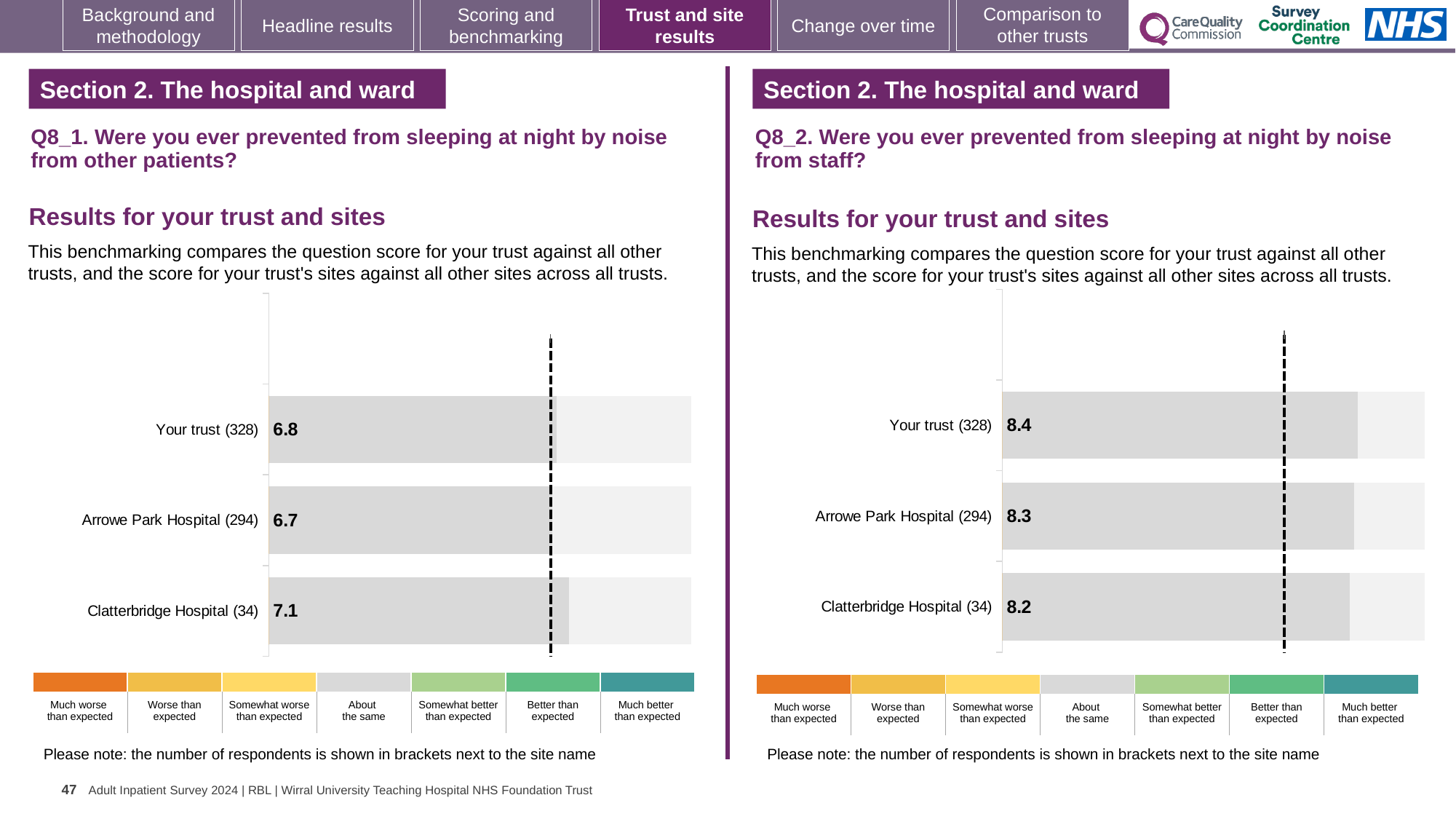
On the Q8_1 chart (noise from other patients), what is the difference between the Clatterbridge Hospital score and the Arrowe Park Hospital score? 0.4 On the Q8_1 chart (noise from other patients), what is the score for Your trust? 6.8 On the Q8_1 chart (noise from other patients), what is the score for Clatterbridge Hospital? 7.1 On the Q8_2 chart (noise from staff), what is the score for Your trust? 8.4 What type of chart is used on the Q8_2 chart (noise from staff)? Bar chart On the Q8_2 chart (noise from staff), what is the score for Arrowe Park Hospital? 8.3 On the Q8_1 chart (noise from other patients), which site or trust has the highest score? Clatterbridge Hospital How many bars are plotted on the Q8_1 chart (noise from other patients)? 3 On the Q8_2 chart (noise from staff), what is the difference between the Your trust score and the Clatterbridge Hospital score? 0.2 On the Q8_1 chart, how many respondents are shown in brackets for Clatterbridge Hospital? 34 Which is larger: the Your trust score on the Q8_1 chart or the Your trust score on the Q8_2 chart? Q8_2 (8.4) On the Q8_2 chart (noise from staff), which site or trust has the lowest score? Clatterbridge Hospital